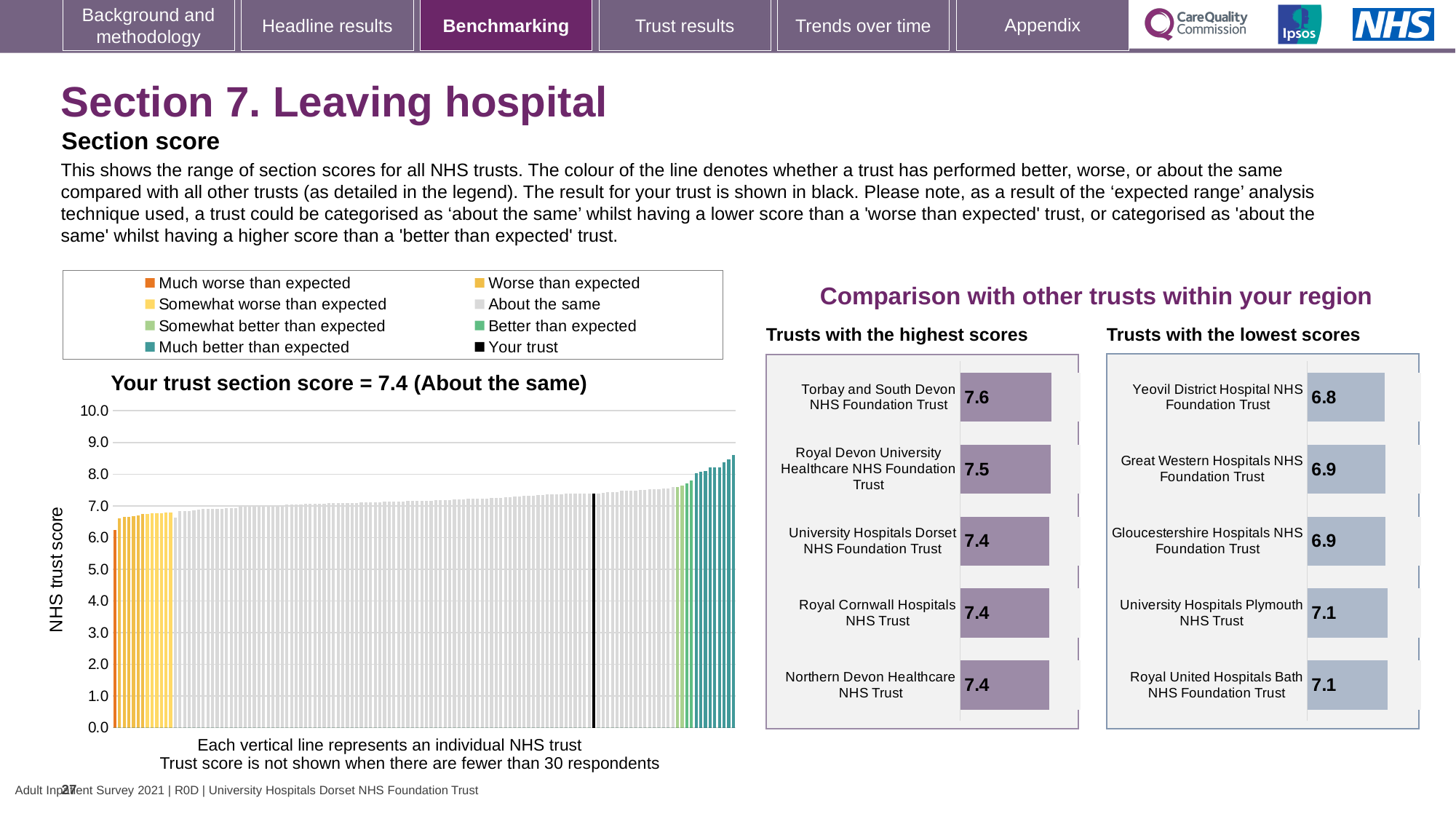
In the 'Trusts with the highest scores' chart, what is the score for Torbay and South Devon NHS Foundation Trust? 7.6 In the 'Trusts with the lowest scores' chart, what is the difference between the scores of Royal United Hospitals Bath NHS Foundation Trust and Yeovil District Hospital NHS Foundation Trust? 0.3 In the 'Trusts with the lowest scores' chart, what is the score for University Hospitals Plymouth NHS Trust? 7.1 In the 'Trusts with the highest scores' chart, how many trusts are listed? 5 In the 'Trusts with the lowest scores' chart, which trust has the lowest score? Yeovil District Hospital NHS Foundation Trust What kind of chart is the 'Your trust section score' chart? Bar chart In the 'Trusts with the lowest scores' chart, what is the score for Yeovil District Hospital NHS Foundation Trust? 6.8 How many entries does the legend above the 'Your trust section score' chart list? 8 In the 'Trusts with the highest scores' chart, which trust has the highest score? Torbay and South Devon NHS Foundation Trust In the 'Trusts with the highest scores' chart, what is the score for Royal Devon University Healthcare NHS Foundation Trust? 7.5 In the 'Your trust section score' chart, is the value of the tallest bar greater or less than 8.0? greater In the 'Trusts with the lowest scores' chart, which has the larger score: Great Western Hospitals NHS Foundation Trust or University Hospitals Plymouth NHS Trust? University Hospitals Plymouth NHS Trust